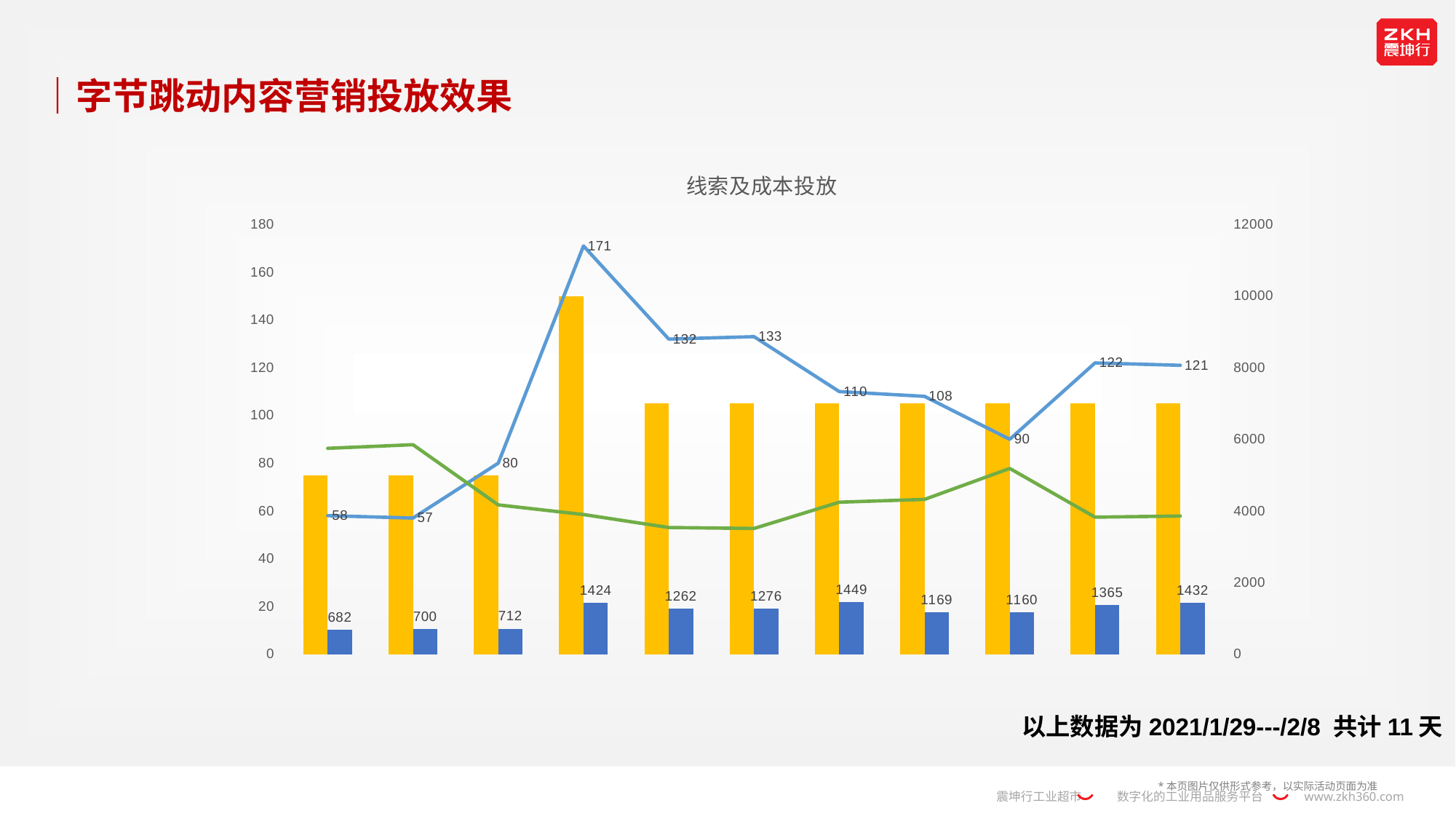
What is the difference between the blue line's fourth point (171) and its fifth point (132)? 39 Is the yellow bar in the fourth group from the left greater or less than 140 on the left axis? greater How many groups of bars are plotted along the x axis? 11 Which is larger: the blue bar in the fourth group from the left or the blue bar in the last group? The last group (1432) What is the lowest labelled value among the blue bars? 682 What is the lowest labelled value on the blue line? 57 What is the labelled value of the blue bar in the fourth group from the left? 1424 What is the highest labelled value among the blue bars? 1449 What is the highest labelled value on the blue line? 171 What is the labelled value of the blue line at the first point from the left? 58 What is the title of the chart? 线索及成本投放 What kind of chart is this? Combined bar and line chart